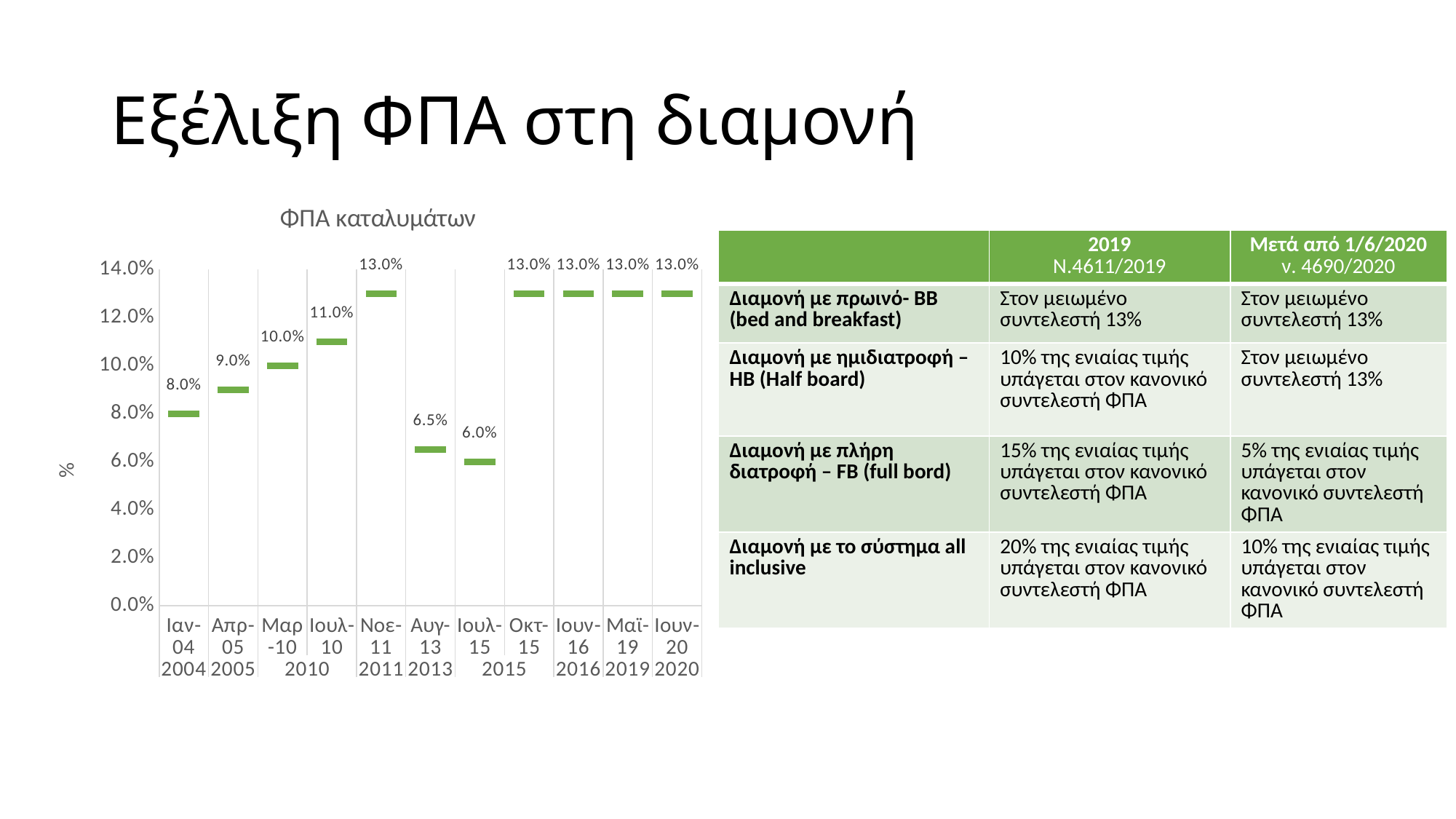
In the chart 'ΦΠΑ καταλυμάτων', is the value for Ιαν-04 2004 greater or less than 10.0%? less In the chart 'ΦΠΑ καταλυμάτων', what is the difference between the values for Νοε-11 2011 and Αυγ-13 2013? 6.5 percentage points In the chart 'ΦΠΑ καταλυμάτων', do the values rise or fall from Ιαν-04 2004 to Νοε-11 2011? rise How many data points are plotted in the chart 'ΦΠΑ καταλυμάτων'? 11 In the chart 'ΦΠΑ καταλυμάτων', what is the value for Ιουλ-10 2010? 11.0% In the chart 'ΦΠΑ καταλυμάτων', what is the value for Ιαν-04 2004? 8.0% What is the label on the vertical axis of the chart 'ΦΠΑ καταλυμάτων'? % In the chart 'ΦΠΑ καταλυμάτων', which date has the lowest value? Ιουλ-15 2015 In the chart 'ΦΠΑ καταλυμάτων', which is larger: the value for Μαρ-10 2010 or the value for Ιουλ-15 2015? Μαρ-10 2010 In the chart 'ΦΠΑ καταλυμάτων', what is the highest value shown? 13.0% In the chart 'ΦΠΑ καταλυμάτων', what is the value for Αυγ-13 2013? 6.5% In the chart 'ΦΠΑ καταλυμάτων', what is the difference between the values for Απρ-05 2005 and Ιαν-04 2004? 1.0 percentage point